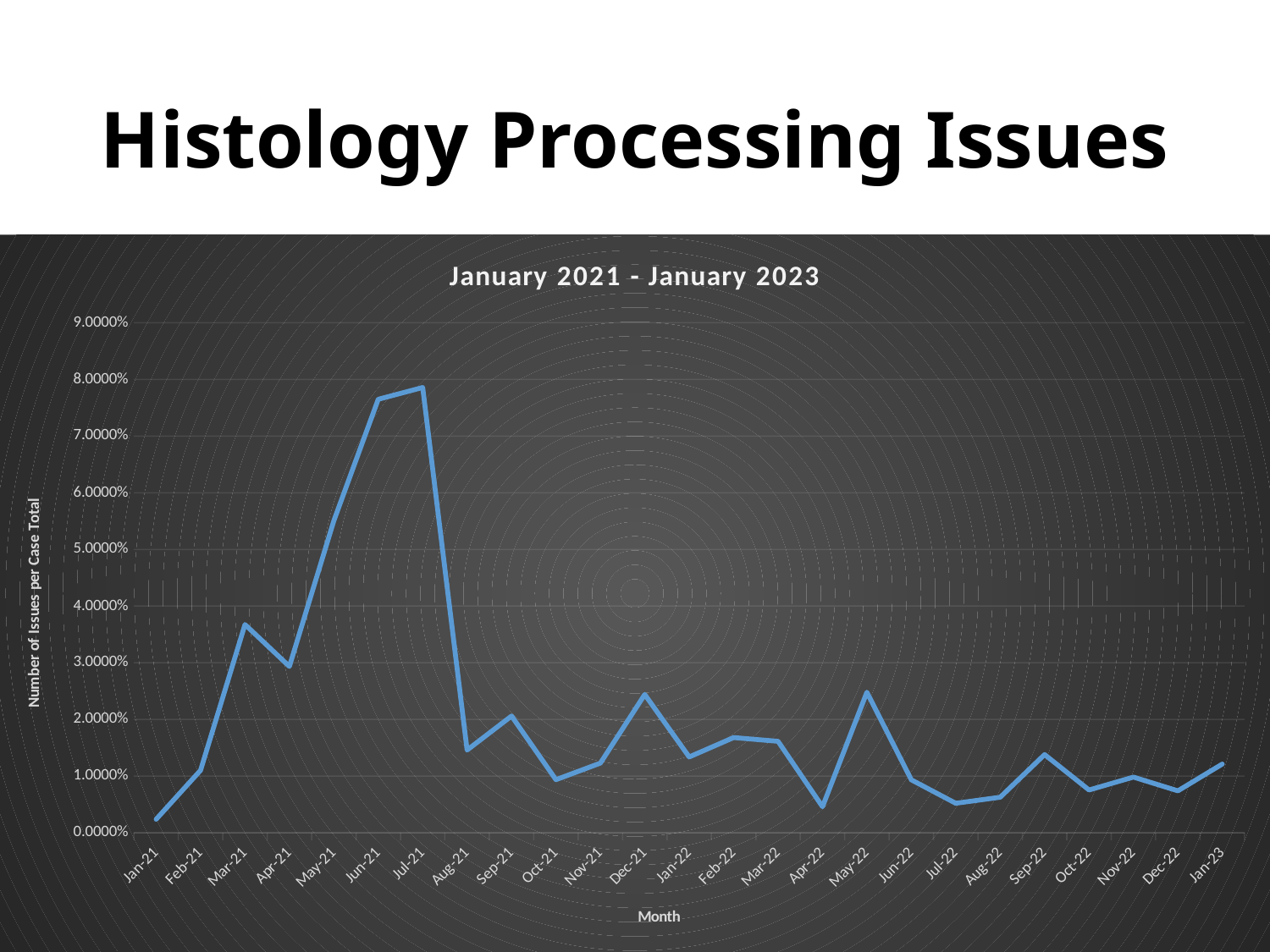
How many months are plotted along the x axis? 25 Is the value for Jul-21 greater or less than 7.0000%? greater Which month has the lowest value? Jan-21 Do the values rise or fall from Jul-21 to Aug-21? Fall What is the label of the vertical axis? Number of Issues per Case Total What kind of chart is shown on the slide? Line chart Is the value for May-22 greater or less than 2.0000%? greater Is the value for Mar-21 greater or less than 3.0000%? greater Which is larger, the value for Mar-21 or the value for Apr-21? Mar-21 Which month has the highest value? Jul-21 What is the title of the chart? January 2021 - January 2023